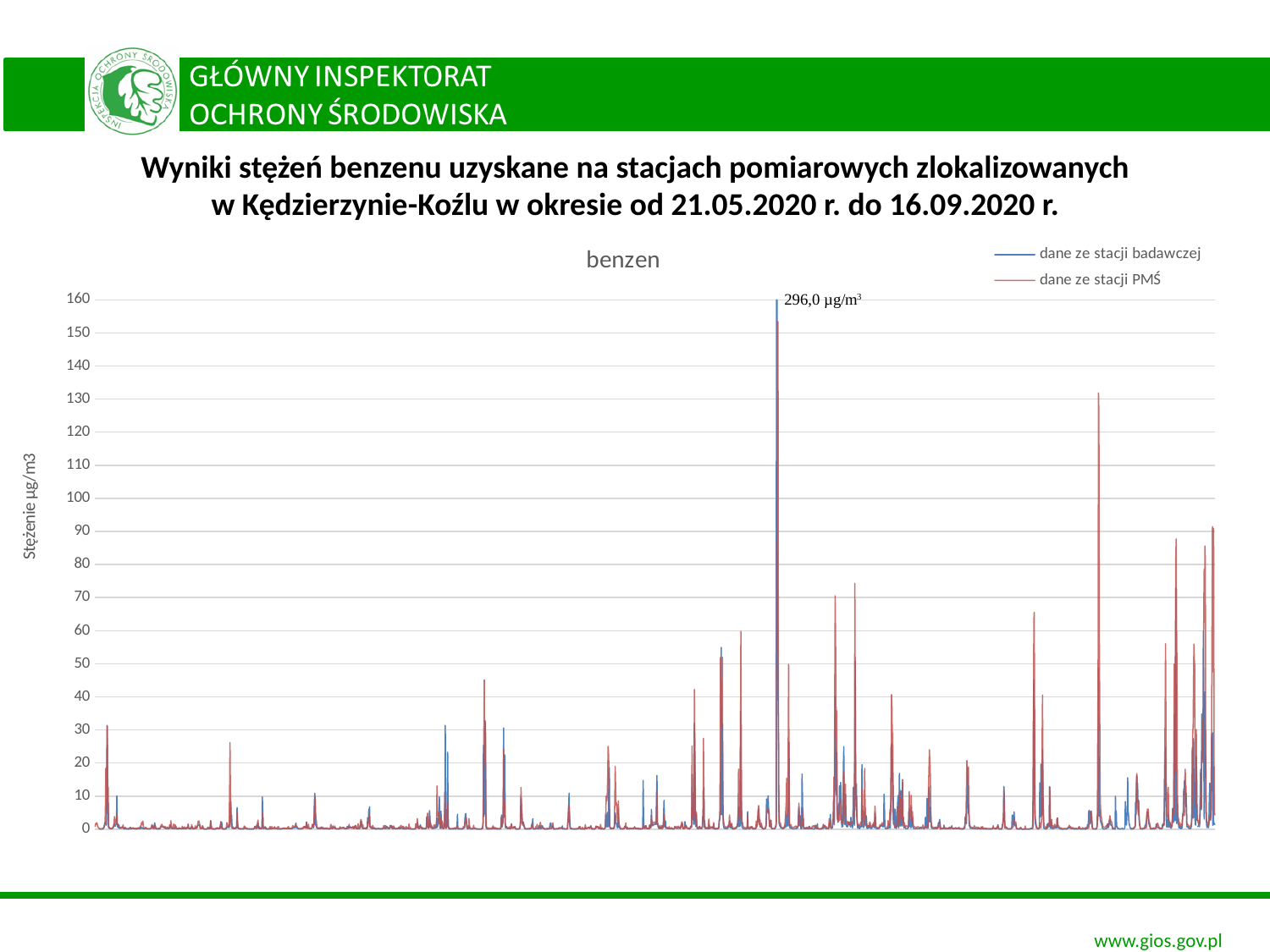
Is the highest red spike in the right part of the chart (near the right edge) greater or less than 80? greater Is the isolated red spike that rises to about the 130 gridline greater or less than 120? greater Is the value of the tallest red spike in the chart greater or less than 100? greater What value is printed as a label next to the tallest peak in the chart? 296,0 µg/m³ What kind of chart is shown on the slide? line chart Which colour is used for the series "dane ze stacji PMŚ"? red What is the title of the chart? benzen How many series does the legend of the chart list? 2